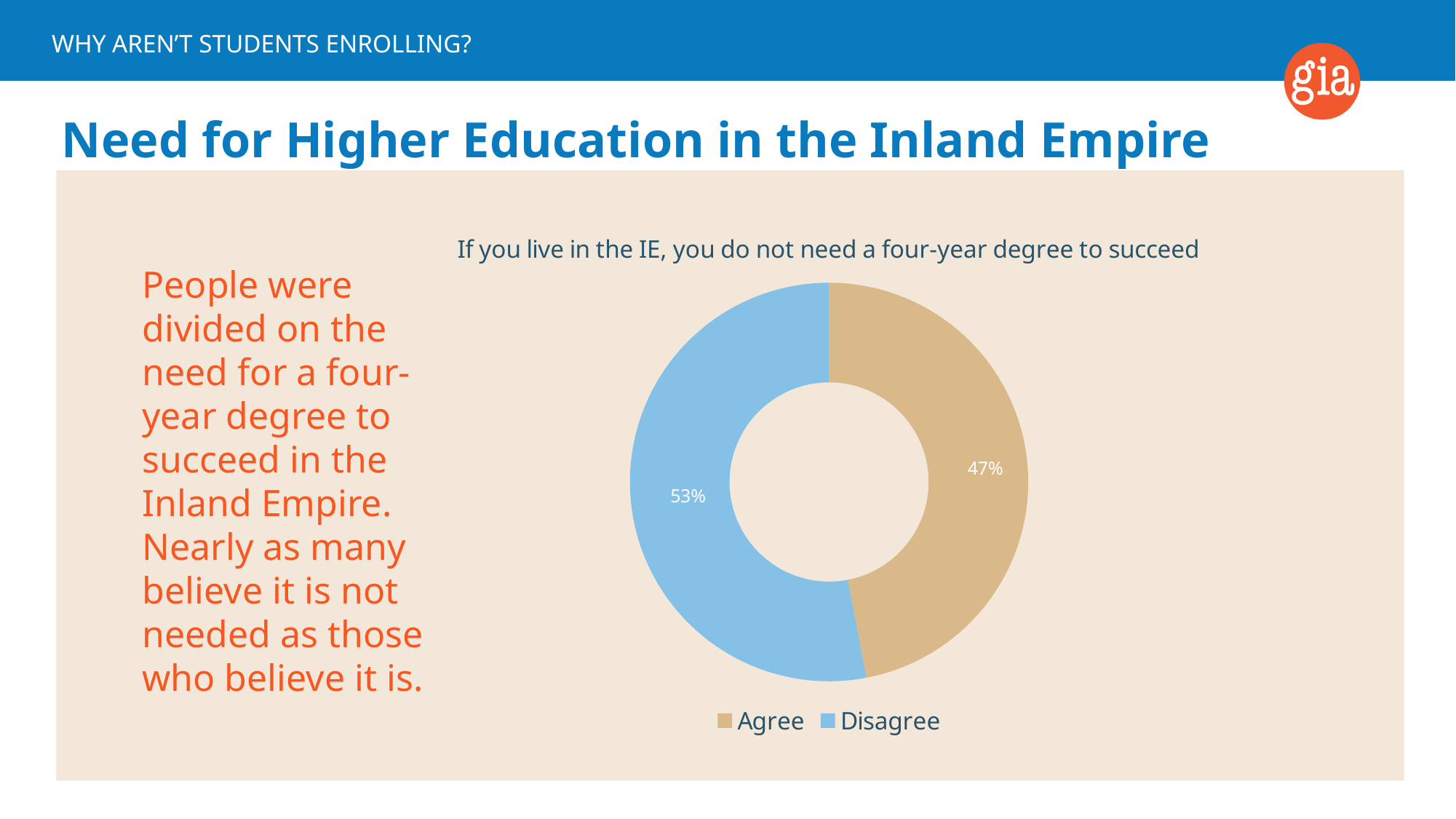
What is the difference in percentage points between the Disagree and Agree shares? 6 How many categories does the chart show? 2 How many entries does the legend list? 2 Is the share for Disagree greater or less than 50%? greater Is the share for Agree larger or smaller than the share for Disagree? smaller Which response has the larger share of the pie, Agree or Disagree? Disagree What kind of chart is shown on the slide? Pie chart (doughnut) What percentage of respondents disagree that if you live in the IE, you do not need a four-year degree to succeed? 53% What is the title of the chart? If you live in the IE, you do not need a four-year degree to succeed Which response has the smaller share of the pie? Agree What percentage of respondents agree that if you live in the IE, you do not need a four-year degree to succeed? 47% Which colour represents Disagree in the chart? Blue